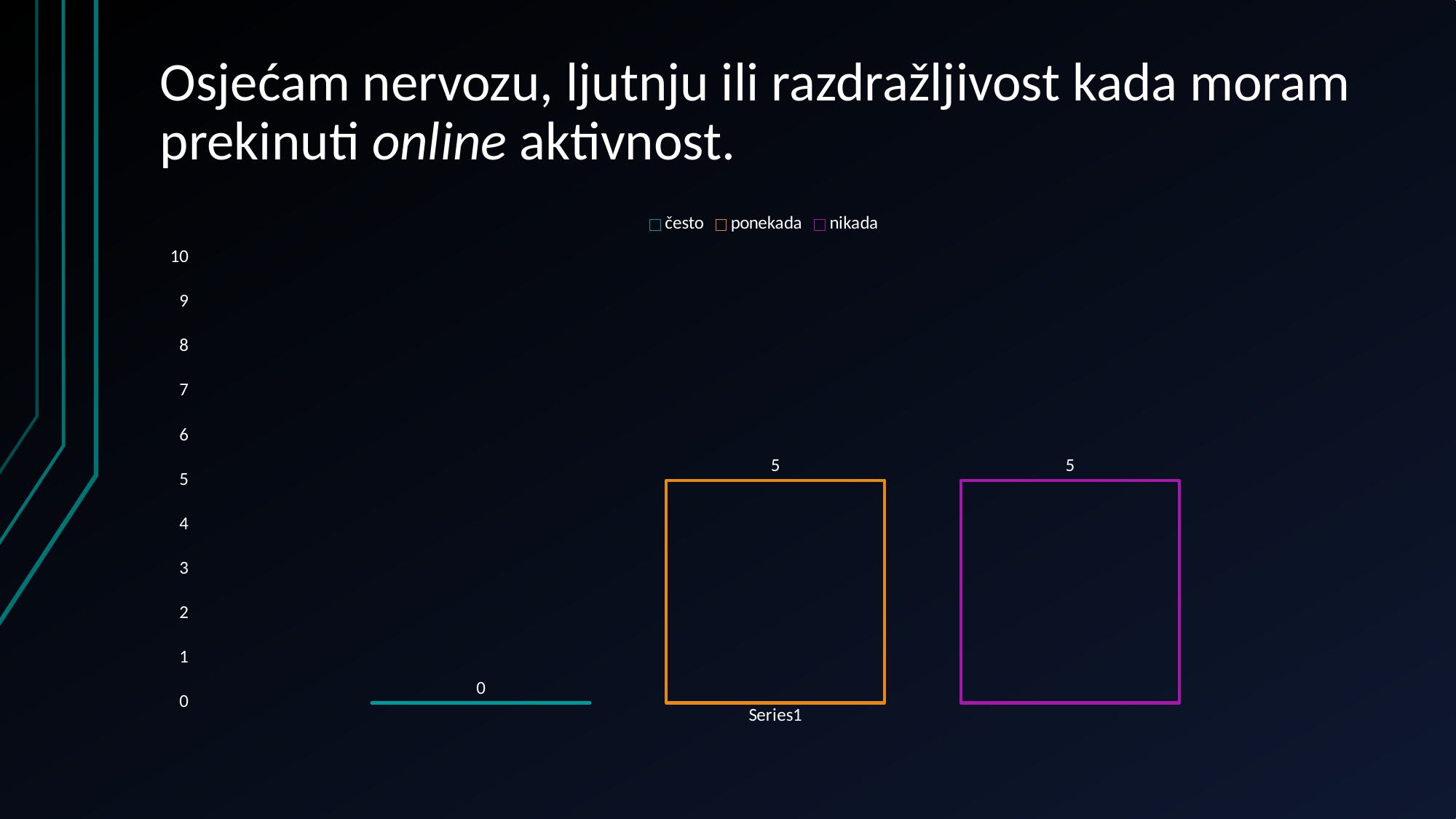
What is the category label shown on the horizontal axis? Series1 What kind of chart is shown on the slide? bar chart Which series has the lowest value? često Which is larger, the value for "nikada" or the value for "često"? nikada What is the total of the three plotted values? 10 How many series does the legend list? 3 What is the difference between the values for "ponekada" and "često"? 5 What is the highest value shown on the vertical axis? 10 What is the value for "nikada"? 5 What is the value for "ponekada"? 5 What is the value for "često"? 0